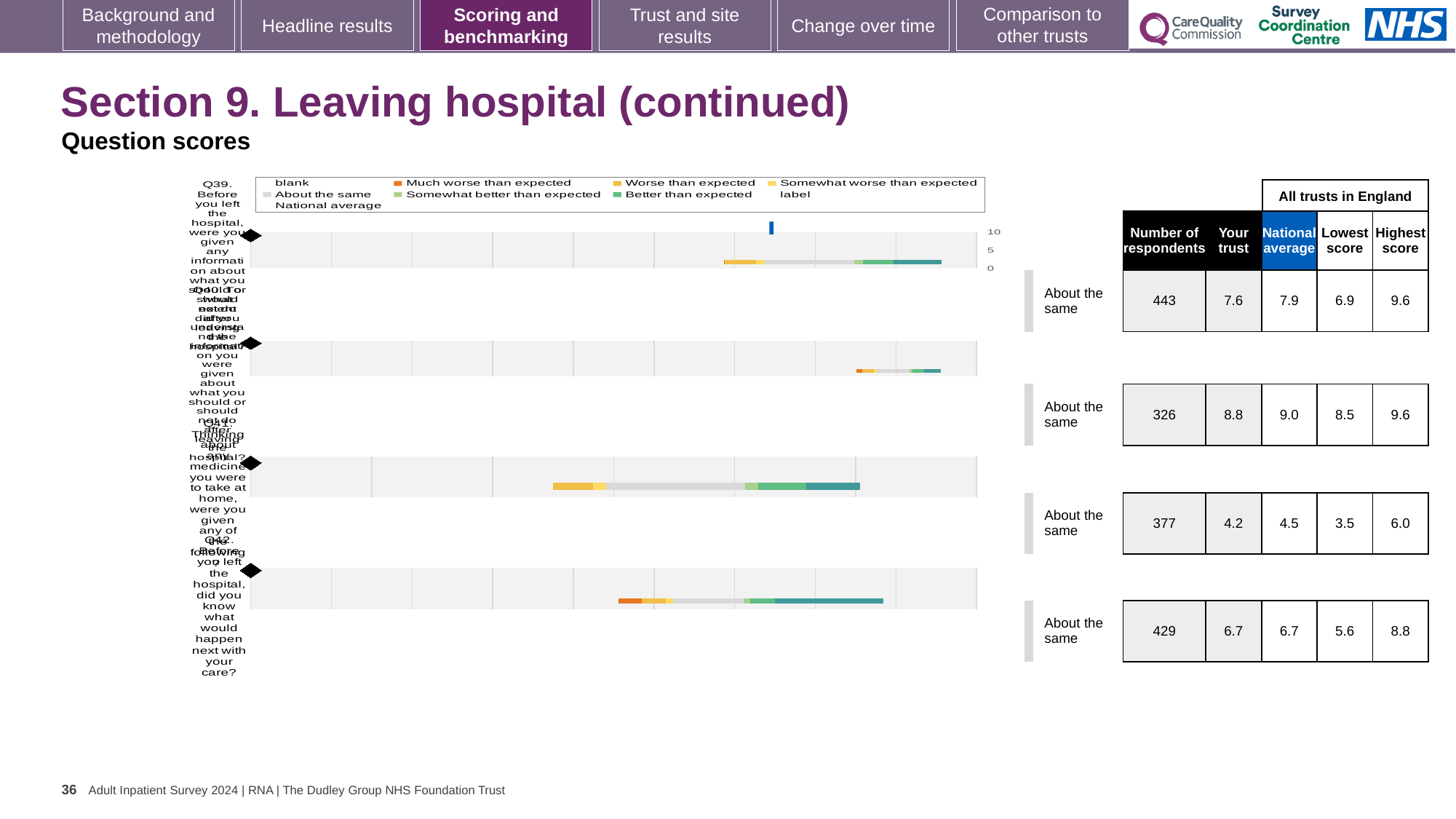
Which question (Q39, Q40, Q41 or Q42) has the highest 'Your trust' score in the table? Q40 For Q39, what is the difference between the National average and the 'Your trust' score? 0.3 How many question charts (Q39 to Q42) are shown on the slide? 4 In the table beside the Q42 chart, what is the number of respondents? 429 In the table beside the Q41 chart, what is the National average score? 4.5 Which question (Q39, Q40, Q41 or Q42) has the lowest 'Your trust' score in the table? Q41 What kind of chart is used for the Q39 to Q42 question scores on this slide? bar chart For Q40, which is larger: the 'Your trust' score or the National average? National average In the chart legend, what colour represents 'Much worse than expected'? orange In the table beside the Q39 chart, what is the 'Your trust' score? 7.6 For Q42, what is the difference between the Highest score and the Lowest score in the table? 3.2 What benchmark category label is shown next to each of the four question charts? About the same